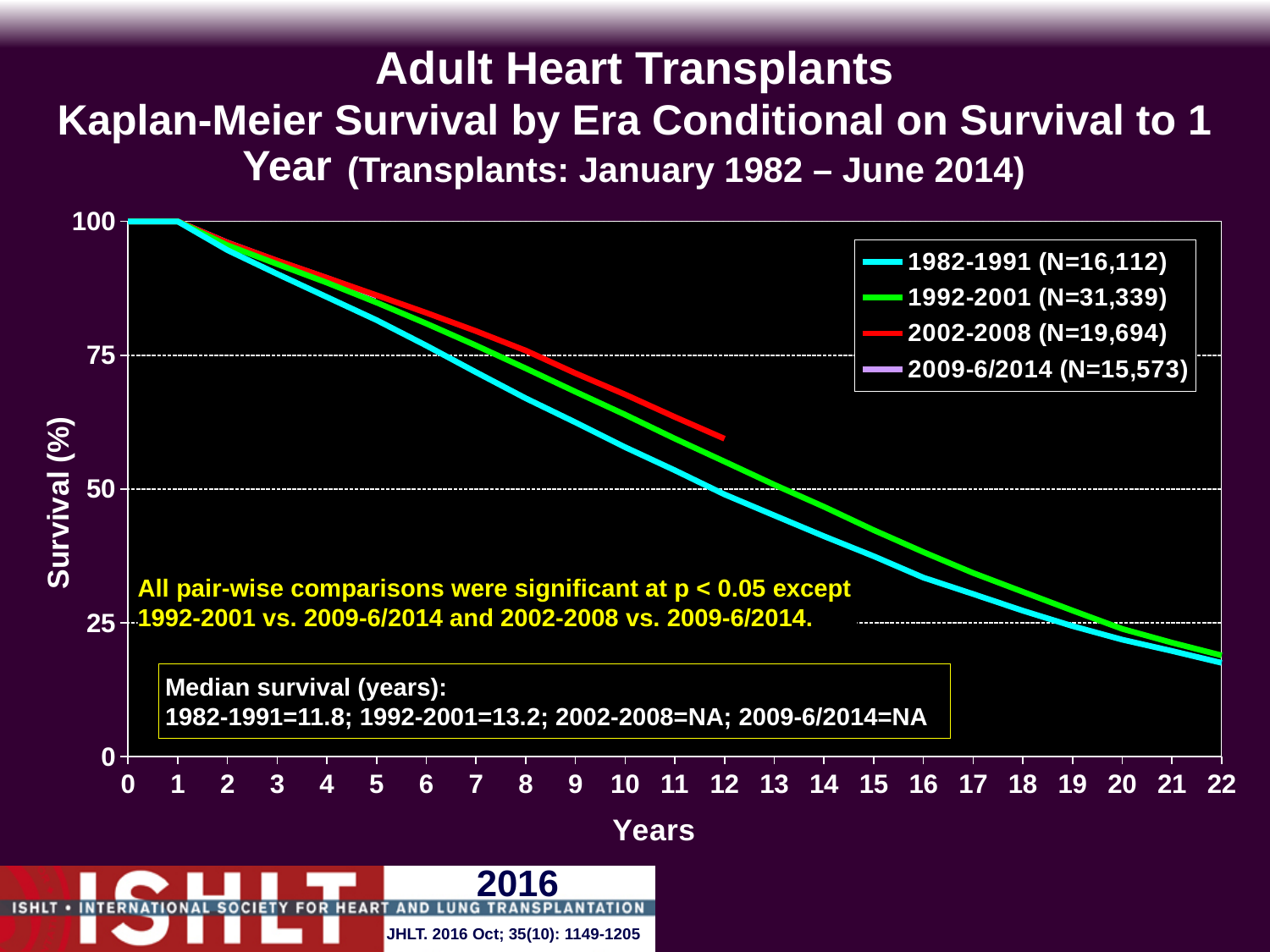
What is the difference in median survival (years) between the 1992-2001 and 1982-1991 eras? 1.4 What is the median survival in years for the 1992-2001 era? 13.2 Which era has the largest N in the legend? 1992-2001 What kind of chart is shown on the slide? line chart Is the survival for the 2002-2008 era at 12 years greater or less than 50? greater Do the survival curves rise or fall as years increase? fall At 10 years, which era has higher survival, 1982-1991 or 1992-2001? 1992-2001 What is the median survival in years for the 1982-1991 era? 11.8 What is the N for the 1992-2001 era shown in the legend? 31,339 Which era has the smallest N in the legend? 2009-6/2014 How many series does the legend list? 4 Is the survival for the 1982-1991 era at 15 years greater or less than 50? less